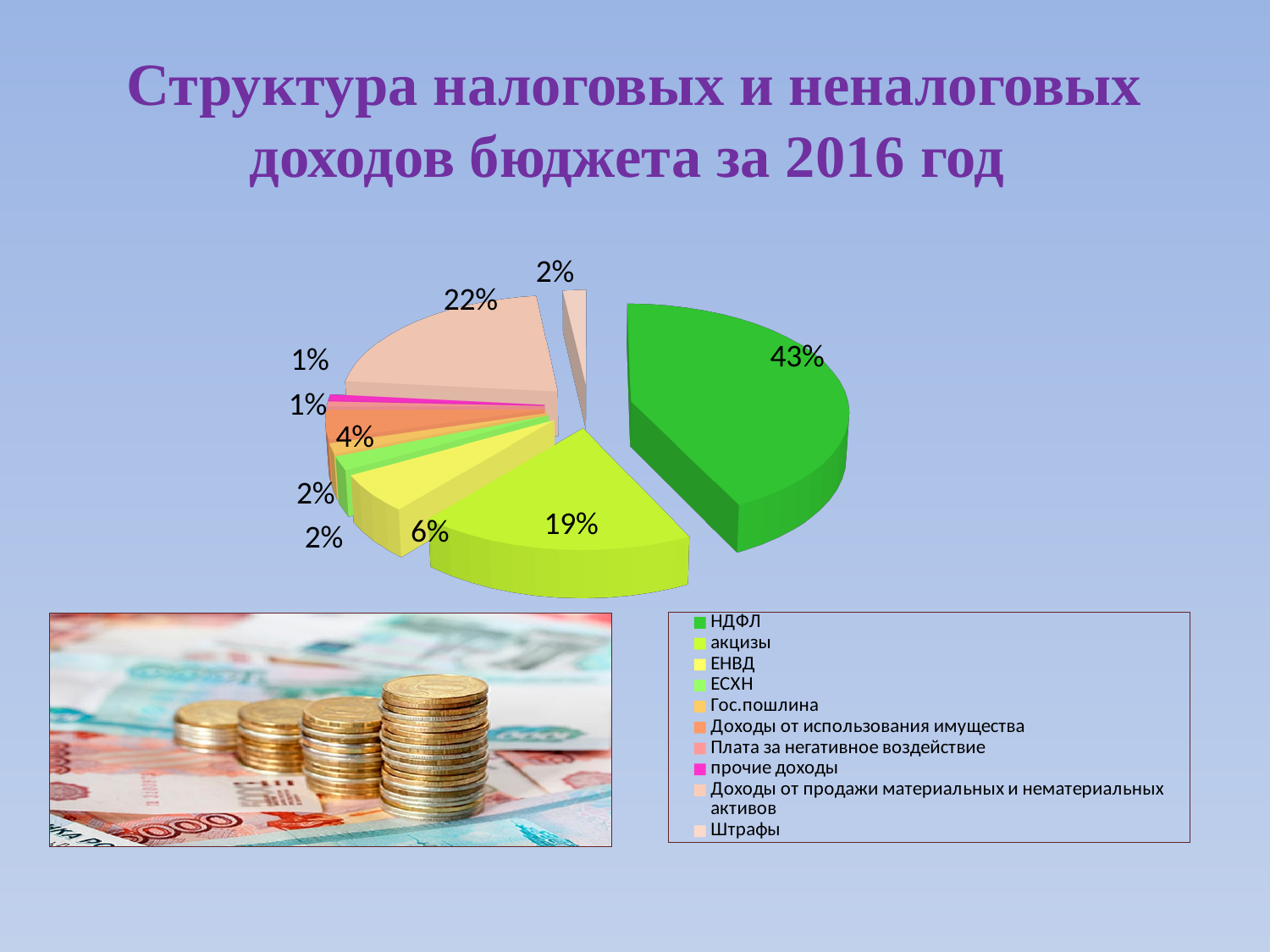
What share of the pie does НДФЛ have? 43% What share of the pie does Доходы от продажи материальных и нематериальных активов have? 22% What is the title of the slide containing the pie chart? Структура налоговых и неналоговых доходов бюджета за 2016 год What type of chart is shown on the slide? pie chart What share of the pie does ЕНВД have? 6% What share of the pie does акцизы have? 19% How many slices does the pie chart have? 10 What share of the pie does Штрафы have? 2% What share of the pie does Доходы от использования имущества have? 4% Which category has the largest share of the pie? НДФЛ Which has the larger share: акцизы or Доходы от продажи материальных и нематериальных активов? Доходы от продажи материальных и нематериальных активов By how many percentage points does the share of НДФЛ exceed the share of акцизы? 24